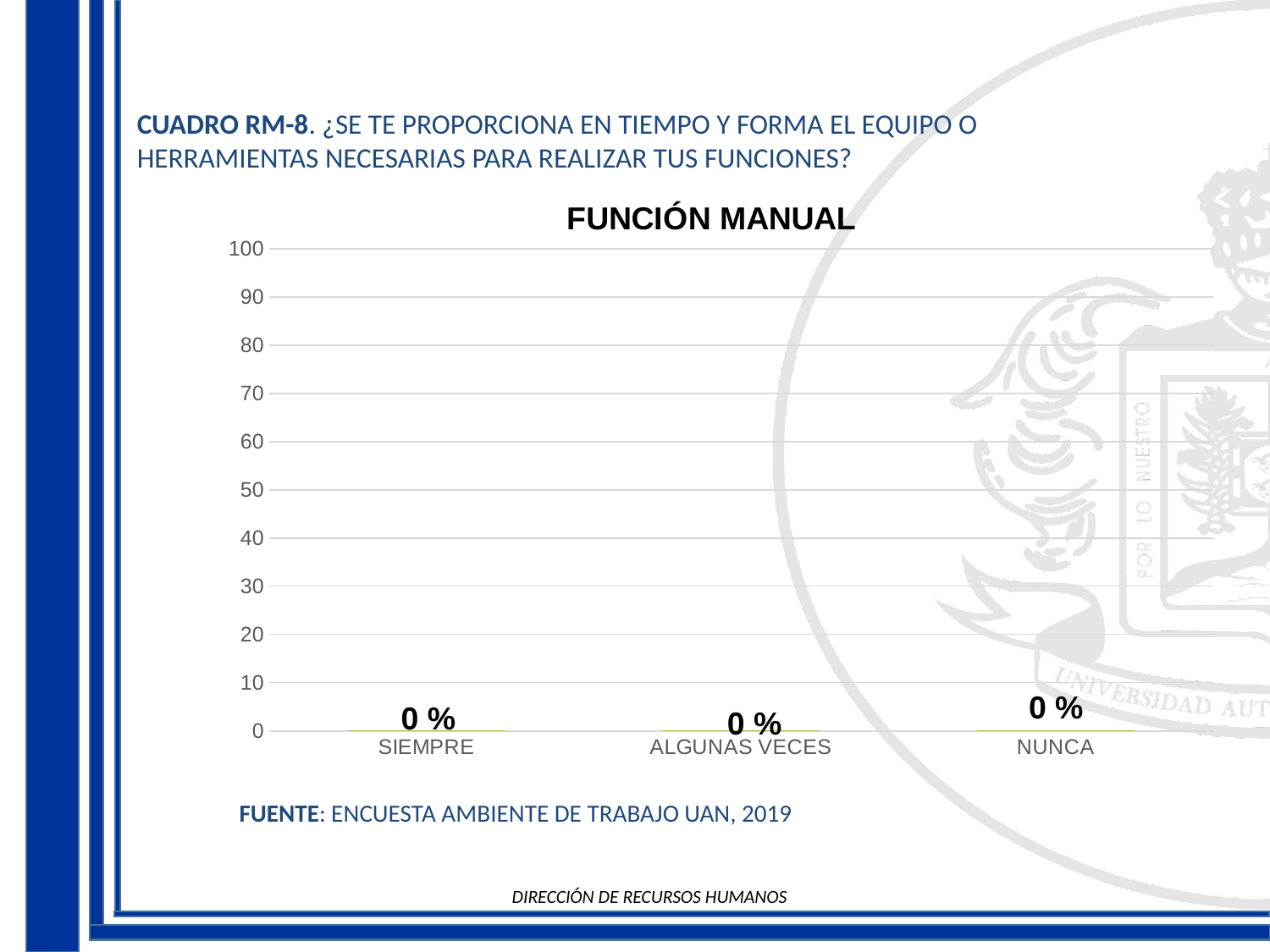
Is the value for NUNCA greater or less than 50? less What is the value for SIEMPRE? 0 % What is the title of the chart? FUNCIÓN MANUAL What kind of chart is shown on the slide? bar chart Is the value for SIEMPRE greater or less than 10? less How many categories are shown on the x axis? 3 What is the highest value shown on the y axis? 100 What is the value for ALGUNAS VECES? 0 % What is the value for NUNCA? 0 % What is the total of the values for SIEMPRE, ALGUNAS VECES and NUNCA? 0 % What is the difference between the values for SIEMPRE and NUNCA? 0 %